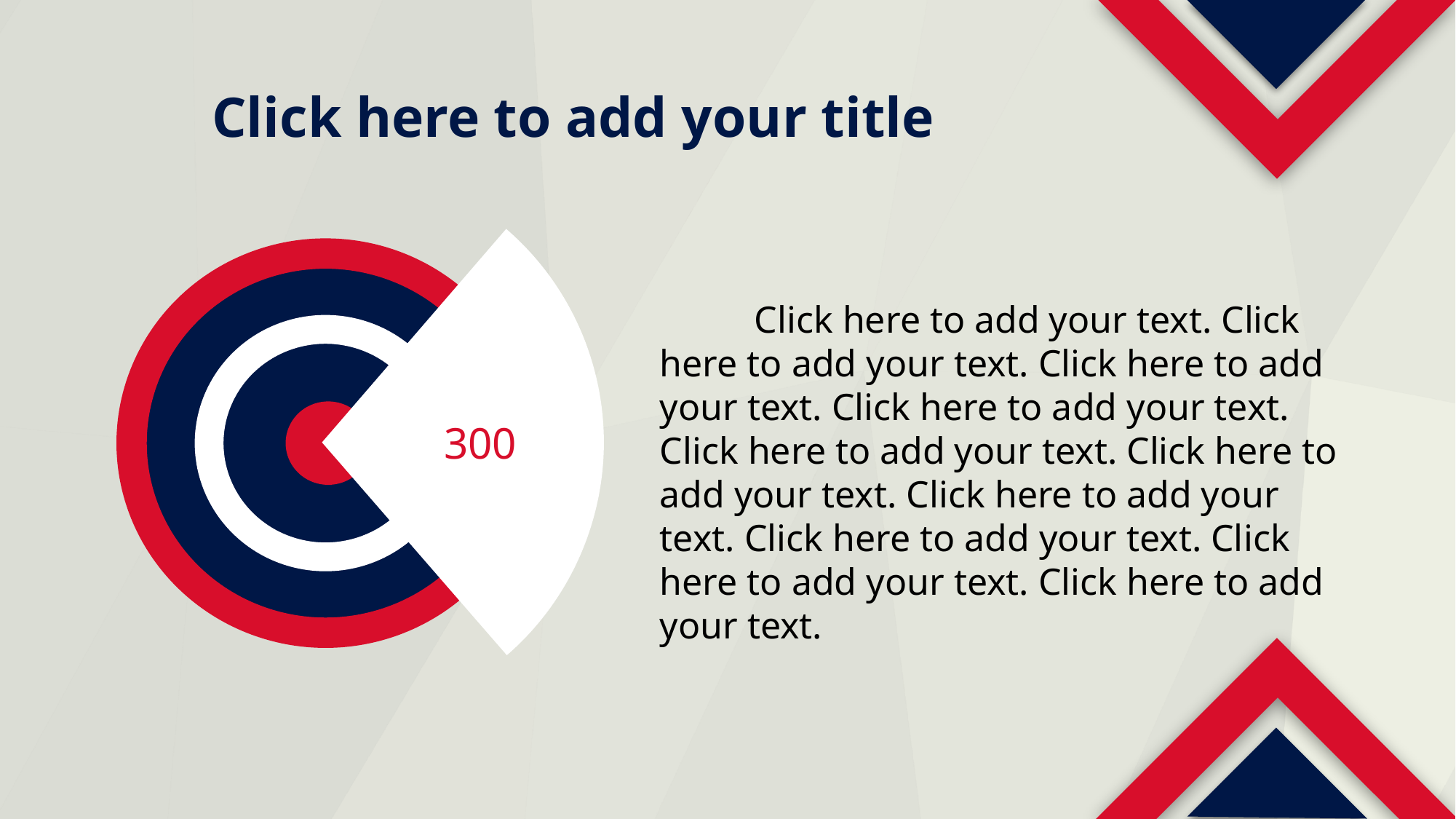
Is the value printed on the circular graphic greater or less than 200? greater What value is printed on the white wedge of the circular graphic on the left of the slide? 300 How many data labels are printed on the circular graphic on the left of the slide? 1 What colour is the wedge that carries the label 300 in the circular graphic? White